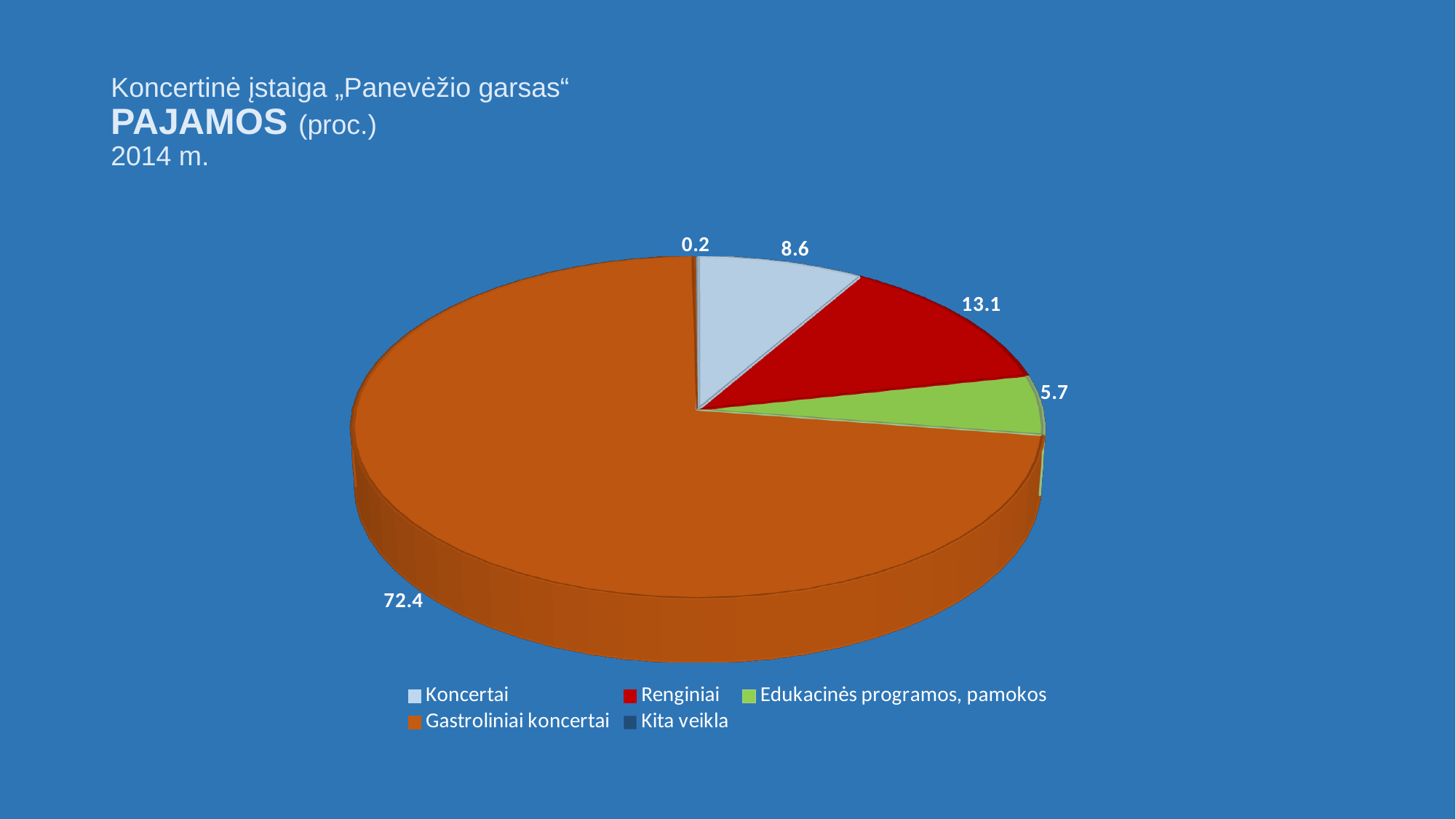
What kind of chart is shown on the slide? pie chart What is the value for Koncertai? 8.6 Which category has the largest slice of the pie? Gastroliniai koncertai How many categories does the legend list? 5 What is the value for Edukacinės programos, pamokos? 5.7 What is the difference between the values for Renginiai and Koncertai? 4.5 Which is larger, the value for Koncertai or the value for Edukacinės programos, pamokos? Koncertai Which category has the smallest slice of the pie? Kita veikla What is the value for Renginiai? 13.1 Which year does the chart title refer to? 2014 m. What is the value for Kita veikla? 0.2 What is the value for Gastroliniai koncertai? 72.4